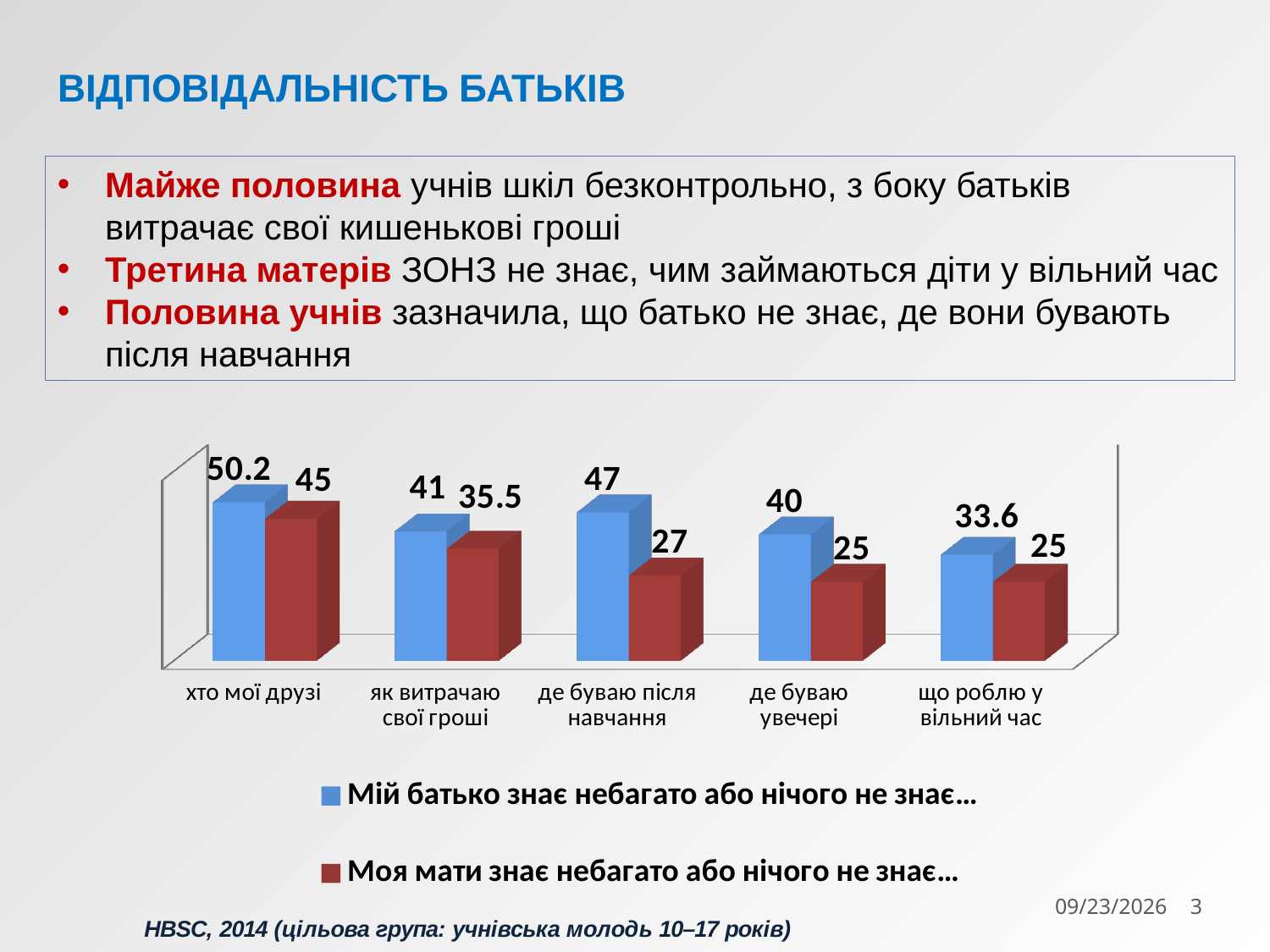
What is the value for "хто мої друзі" in the series "Мій батько знає небагато або нічого не знає…"? 50.2 What is the value for "де буваю після навчання" in the series "Моя мати знає небагато або нічого не знає…"? 27 Which category has the highest value in the series "Моя мати знає небагато або нічого не знає…"? хто мої друзі What is the value for "як витрачаю свої гроші" in the series "Моя мати знає небагато або нічого не знає…"? 35.5 How many series does the chart legend list? 2 How many categories are shown on the x axis of the chart? 5 Which category has the highest value in the series "Мій батько знає небагато або нічого не знає…"? хто мої друзі For "як витрачаю свої гроші", which series has the larger value: "Мій батько знає небагато або нічого не знає…" or "Моя мати знає небагато або нічого не знає…"? Мій батько знає небагато або нічого не знає… Which category has the lowest value in the series "Мій батько знає небагато або нічого не знає…"? що роблю у вільний час What is the value for "що роблю у вільний час" in the series "Мій батько знає небагато або нічого не знає…"? 33.6 What is the difference between the father and mother values for "де буваю після навчання"? 20 What is the difference between the father and mother values for "де буваю увечері"? 15